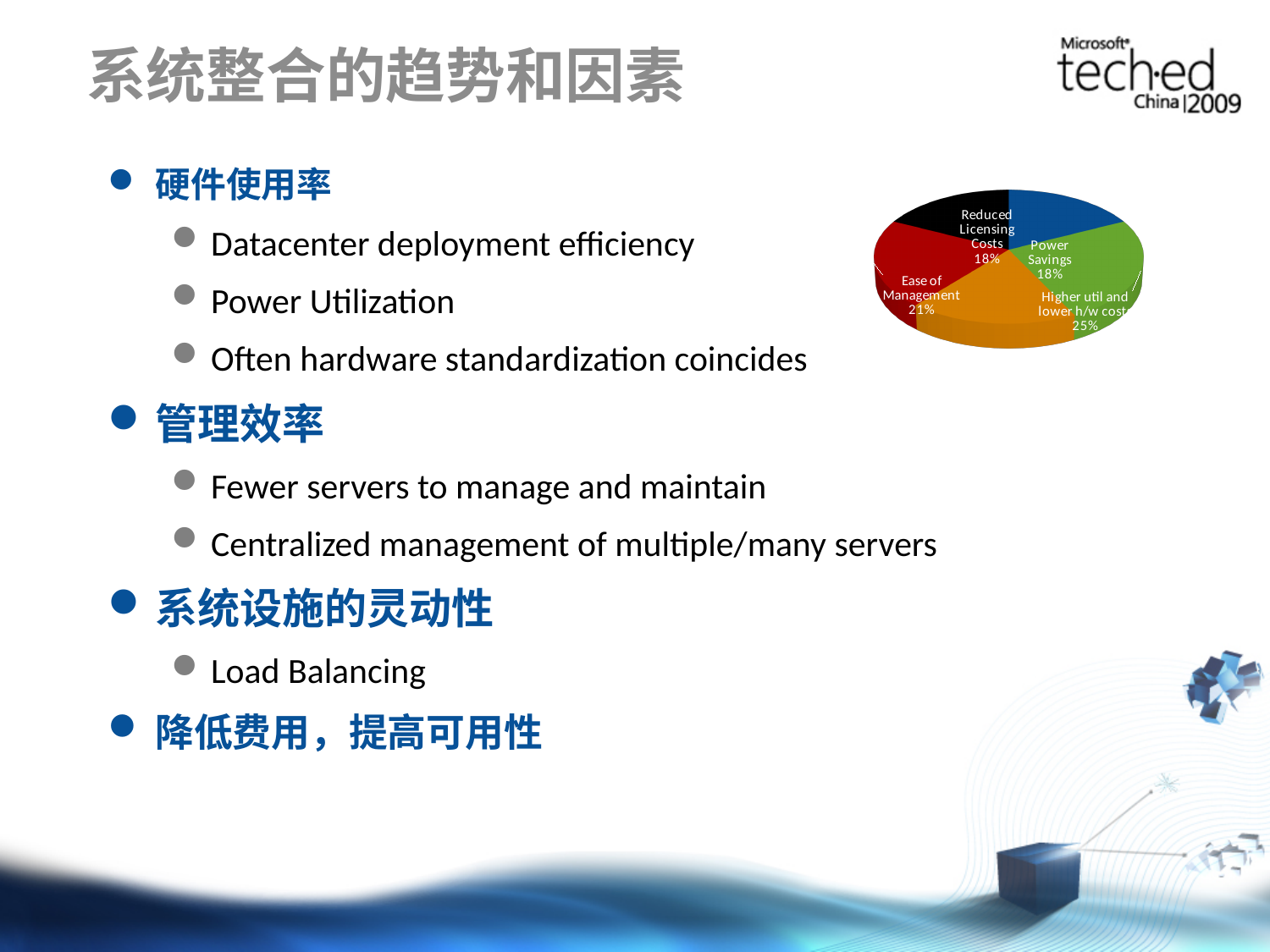
What share of the pie does Ease of Management represent? 21% What percentage does the pie chart show for Reduced Licensing Costs? 18% Is the share for Higher util and lower h/w cost greater or less than 20%? greater What percentage does the pie chart show for Higher util and lower h/w cost? 25% What kind of chart is shown on the slide? pie chart What percentage does the pie chart show for Ease of Management? 21% Which is larger in the pie chart, Higher util and lower h/w cost or Reduced Licensing Costs? Higher util and lower h/w cost Which labelled slice of the pie chart has the largest share? Higher util and lower h/w cost Which is larger in the pie chart, Ease of Management or Power Savings? Ease of Management Do Power Savings and Reduced Licensing Costs have the same percentage in the pie chart? Yes, both 18% What is the difference in percentage points between Higher util and lower h/w cost and Ease of Management? 4 What percentage does the pie chart show for Power Savings? 18%